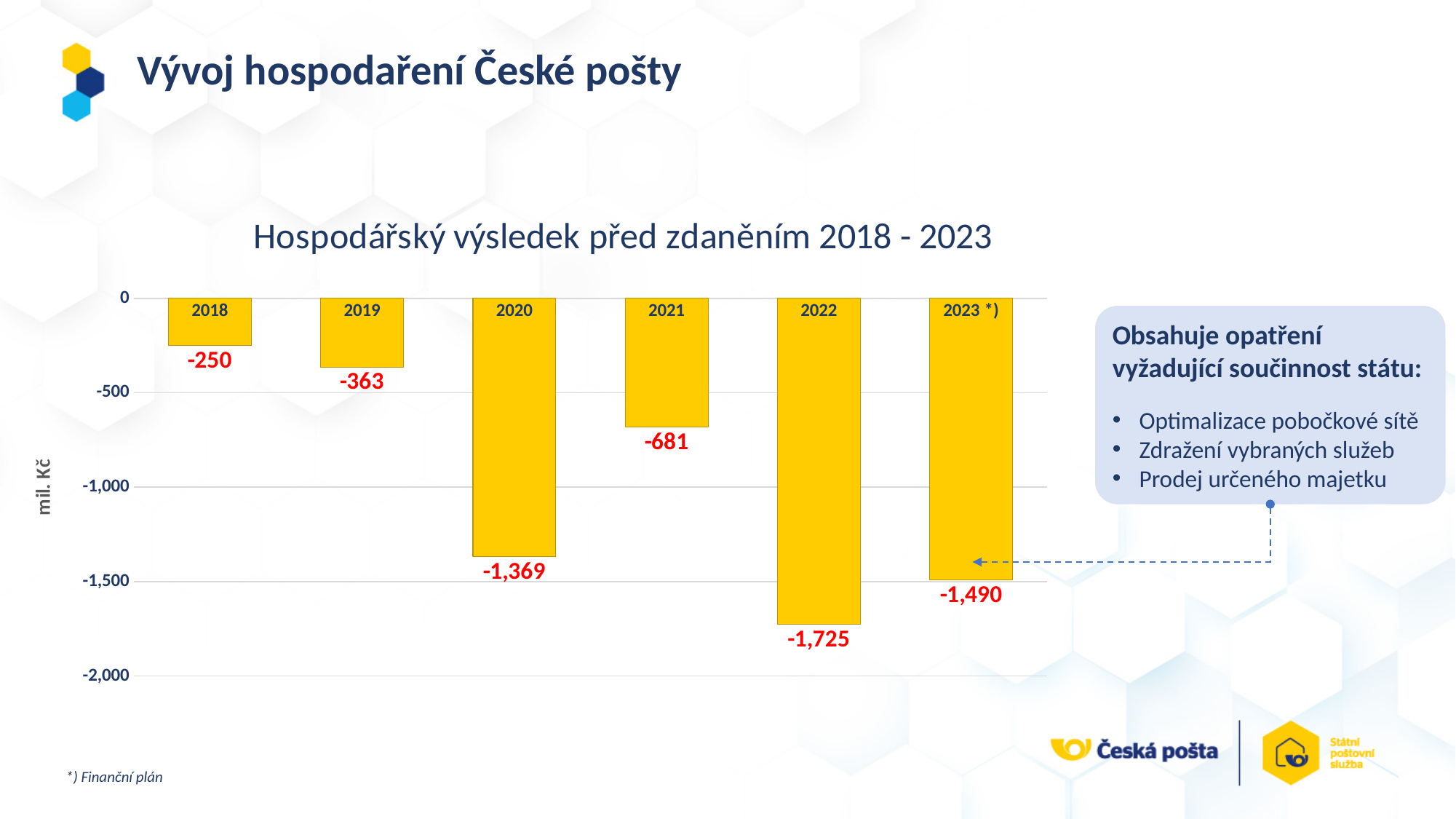
What is the value for 2018? -250 What unit is shown on the vertical axis label? mil. Kč What kind of chart is shown? bar chart What is the difference between the values for 2020 and 2021? 688 What is the value for 2022? -1,725 What is the title of the chart? Hospodářský výsledek před zdaněním 2018 - 2023 What is the value for 2023 *)? -1,490 How many years are shown on the chart? 6 Which year has the highest (least negative) value? 2018 Which is larger, the value for 2019 or the value for 2021? 2019 Is the value for 2020 greater or less than -1,000? less Which year has the lowest (most negative) value? 2022